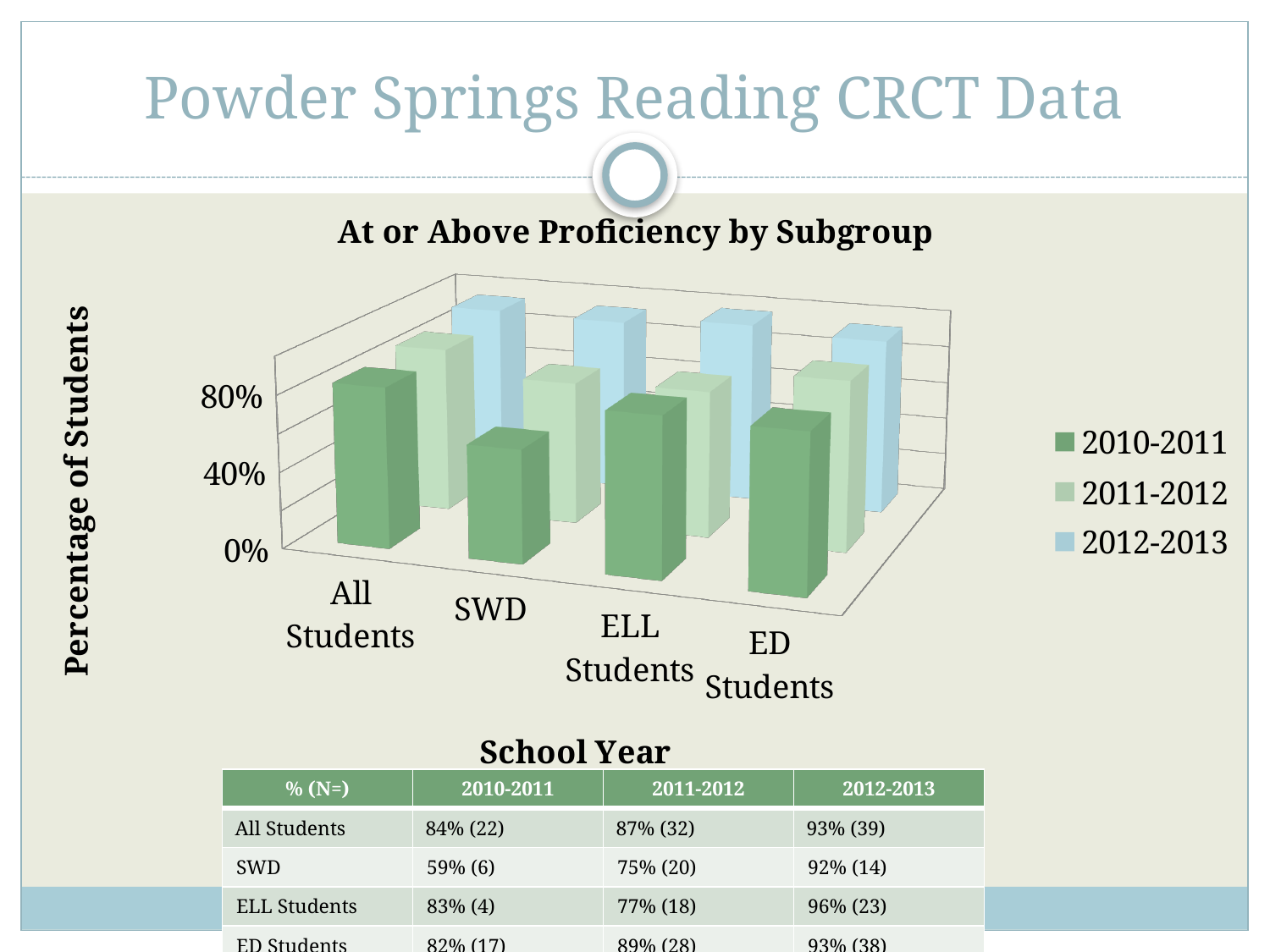
What is the difference between the SWD values for 2012-2013 and 2010-2011? 33% What kind of chart is shown on the slide? bar chart Which subgroup has the lowest value in 2010-2011? SWD Do the values for All Students rise or fall from 2010-2011 to 2012-2013? rise What is the value for ELL Students in 2011-2012? 77% Which subgroup has the highest value in 2012-2013? ELL Students What is the value for All Students in 2012-2013? 93% What is the title of the chart? At or Above Proficiency by Subgroup How many subgroup categories are shown on the x axis? 4 How many series does the legend list? 3 Which is larger for ELL Students: the 2010-2011 value or the 2011-2012 value? 2010-2011 What is the value for SWD in 2010-2011? 59%